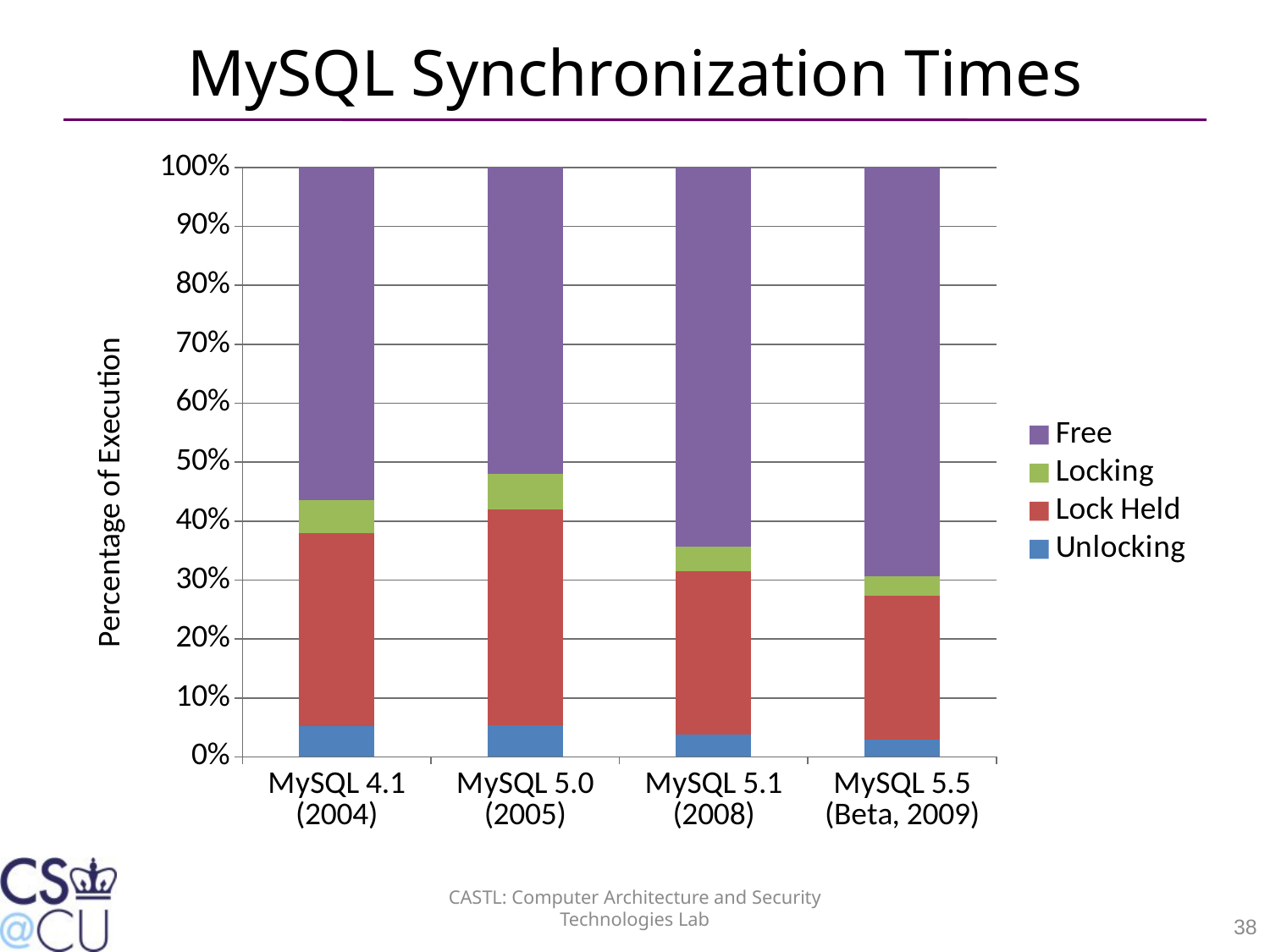
What kind of chart is shown on the slide? Stacked bar chart Which MySQL version has the largest Lock Held share of execution? MySQL 5.0 (2005) Is the Free value for MySQL 5.5 (Beta, 2009) greater or less than 60%? greater How many series does the legend list? 4 Which MySQL version has the largest Free share of execution? MySQL 5.5 (Beta, 2009) Is the Unlocking value for MySQL 5.5 (Beta, 2009) greater or less than 10%? less Which is larger, the Lock Held share for MySQL 4.1 (2004) or for MySQL 5.1 (2008)? MySQL 4.1 (2004) From MySQL 5.0 (2005) to MySQL 5.5 (Beta, 2009), does the Free share rise or fall? rise What is the title of the chart? MySQL Synchronization Times What is the label of the y axis? Percentage of Execution Which MySQL version has the smallest Free share of execution? MySQL 5.0 (2005) How many MySQL versions are plotted along the x axis? 4